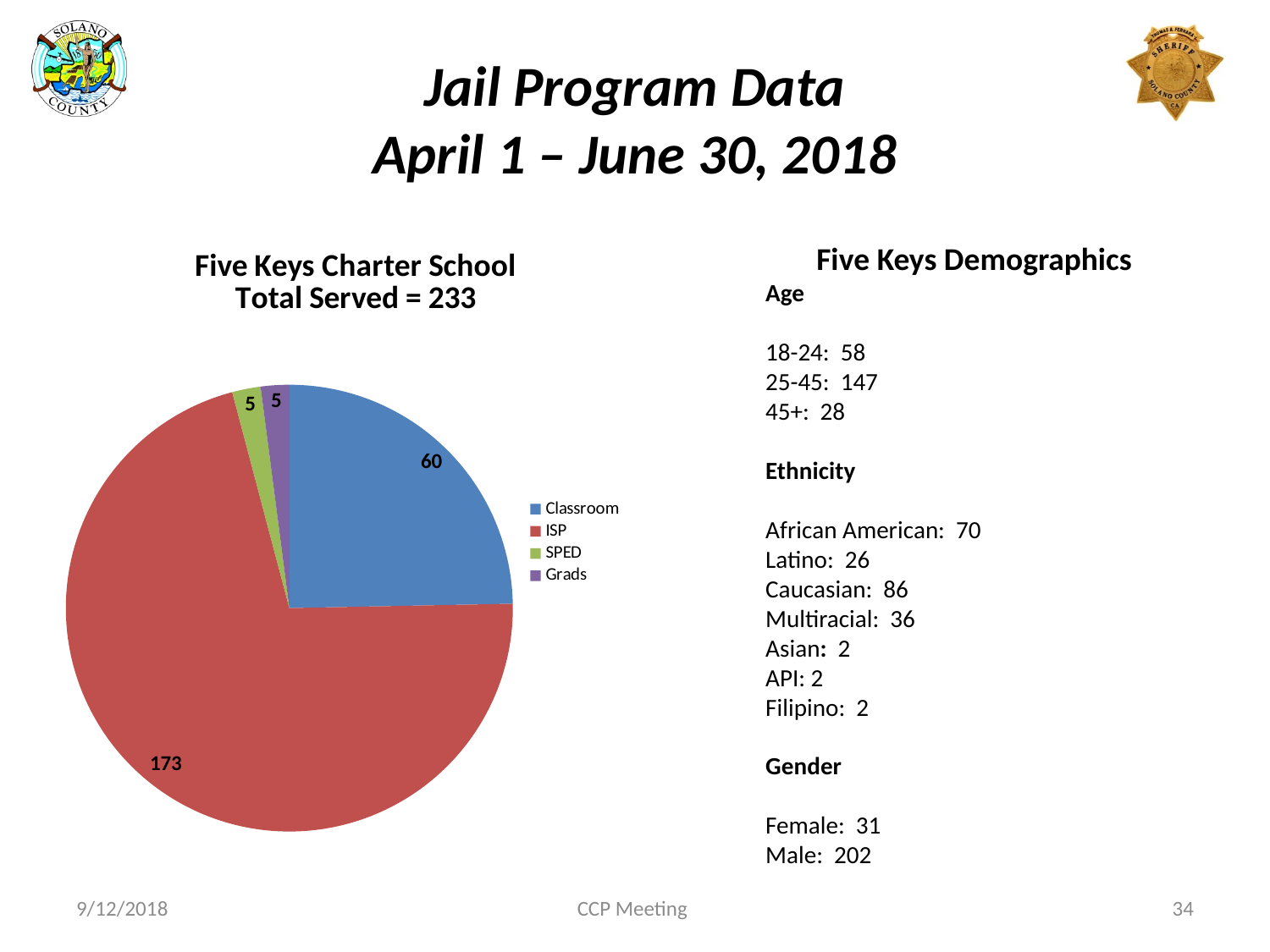
What is the difference between the ISP value and the Classroom value? 113 What is the value for SPED in the Five Keys Charter School pie chart? 5 Which is larger in the pie chart, Classroom or ISP? ISP What is the value for Classroom in the Five Keys Charter School pie chart? 60 What is the value for Grads in the Five Keys Charter School pie chart? 5 What type of chart is shown on the slide? pie chart Which category has the largest slice in the pie chart? ISP What is the title of the pie chart? Five Keys Charter School Total Served = 233 What is the difference between the Classroom value and the SPED value? 55 What is the value for ISP in the Five Keys Charter School pie chart? 173 How many categories are shown in the pie chart? 4 What colour is the ISP slice in the pie chart? red